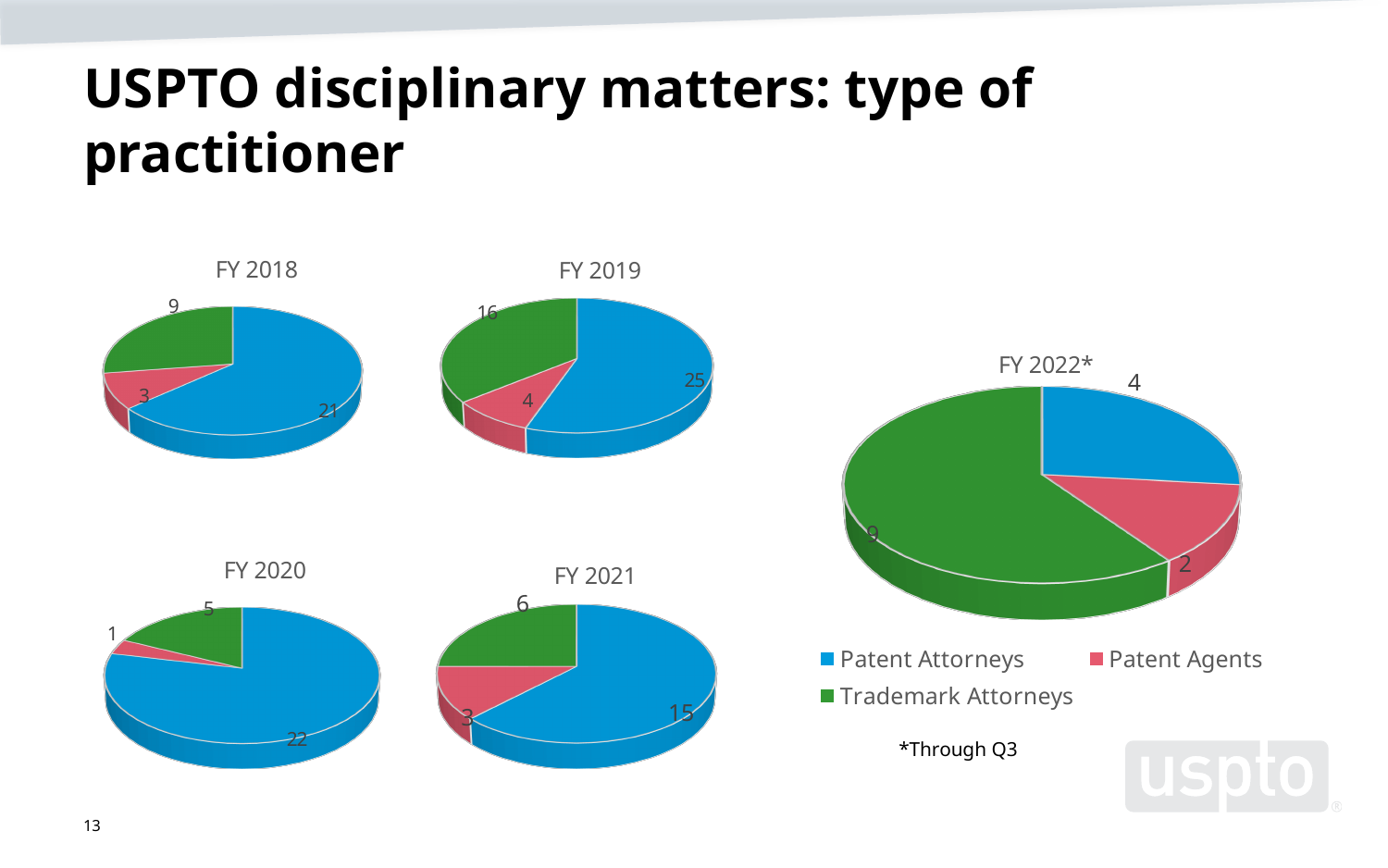
In the FY 2021 chart, what is the value for Patent Attorneys? 15 In the FY 2018 chart, what is the value for Patent Attorneys? 21 In the FY 2021 chart, which is larger: Trademark Attorneys or Patent Agents? Trademark Attorneys How many series does the legend list? 3 In the FY 2020 chart, what is the value for Patent Agents? 1 In the FY 2018 chart, what is the difference between the Patent Attorneys value and the Trademark Attorneys value? 12 In the FY 2022* chart, which category has the largest slice? Trademark Attorneys In the FY 2019 chart, which category has the smallest slice? Patent Agents What kind of chart is the FY 2022* chart? Pie chart In the FY 2022* chart, what share of the total do Patent Agents represent? 2 of 15 In the FY 2019 chart, what is the value for Trademark Attorneys? 16 How many slices does the FY 2020 chart have? 3